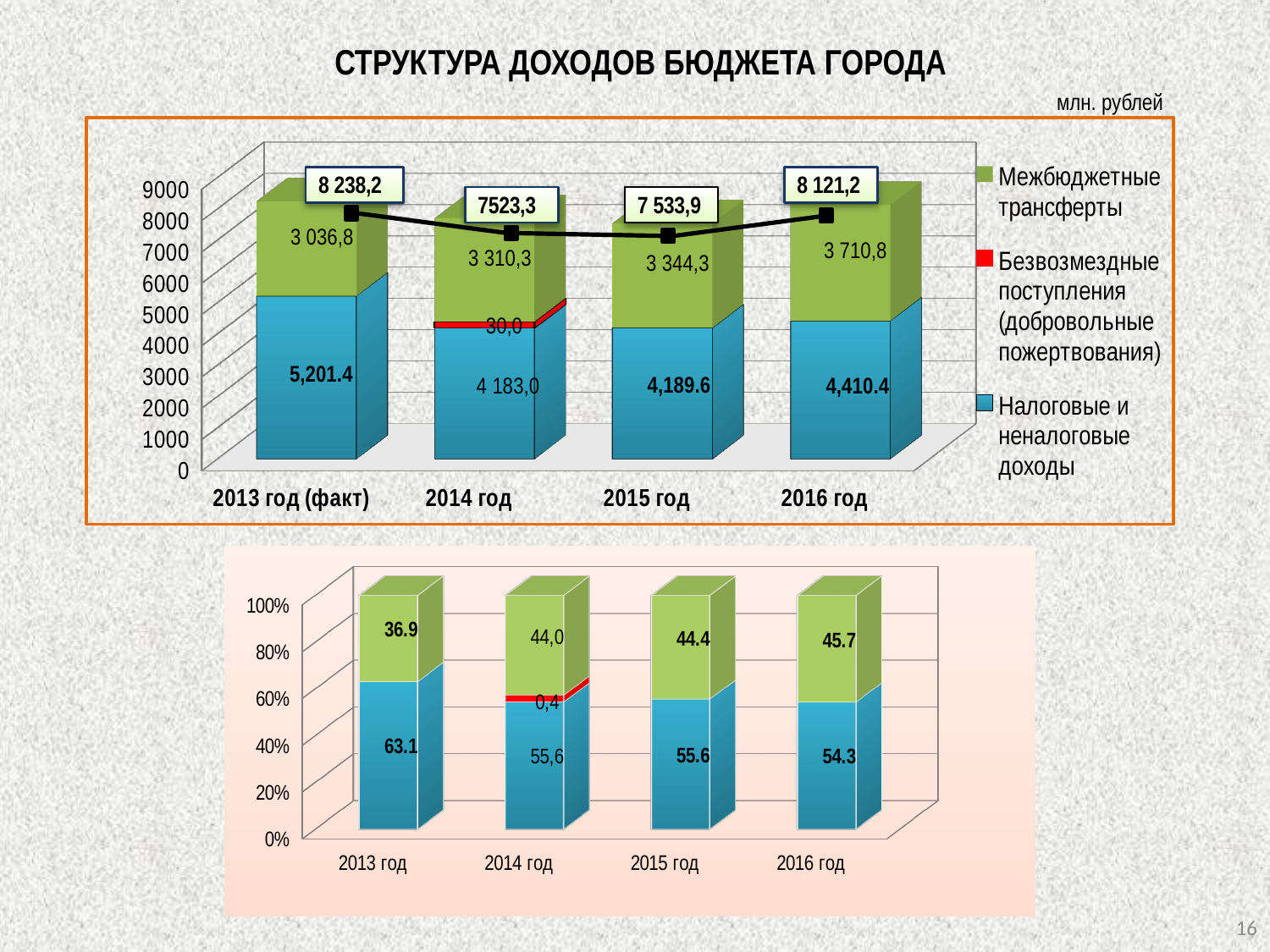
In the top chart, how many series does the legend list? 3 In the top chart, what is the value of Безвозмездные поступления for 2014 год? 30,0 In the top chart, which is larger: Налоговые и неналоговые доходы for 2015 год or for 2016 год? 2016 год In the top chart, what total is labelled on the line for 2015 год? 7 533,9 In the top chart, what is the value of Налоговые и неналоговые доходы for 2013 год (факт)? 5,201.4 In the bottom chart, what is the value of the red segment for 2014 год? 0,4 In the top chart, do the values of Межбюджетные трансферты rise or fall from 2013 to 2016? rise What kind of chart is the bottom chart? bar chart In the top chart, which year has the lowest value of Межбюджетные трансферты? 2013 год (факт) In the top chart, what is the value of Межбюджетные трансферты for 2016 год? 3 710,8 In the top chart, which year has the highest total shown on the line? 2013 год (факт) In the bottom chart, what is the share of the blue segment for 2016 год? 54.3